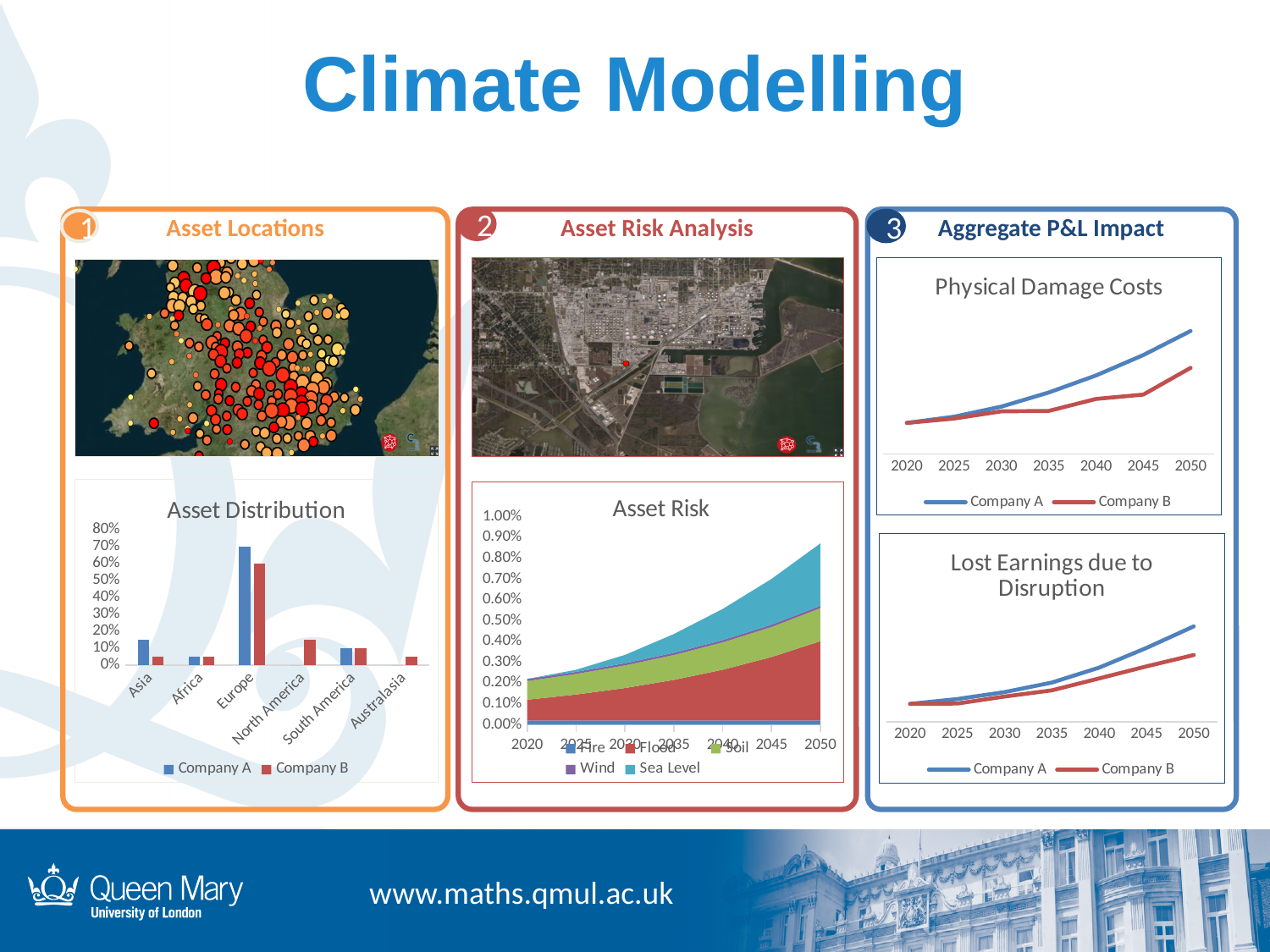
In the Asset Distribution chart, is the Company B value for Europe greater or less than 70%? less In the Asset Risk chart, is the total stacked value in 2050 greater or less than 0.80%? greater How many series does the legend of the Asset Distribution chart list? 2 In the Asset Risk chart, do the stacked values rise or fall from 2020 to 2050? rise In the Asset Distribution chart, which company has the larger value for Europe? Company A In the Asset Distribution chart, is the Company A value for Europe greater or less than 60%? greater In the Asset Distribution chart, which region has the highest value for Company A? Europe How many series does the legend of the Asset Risk chart list? 5 In the Physical Damage Costs chart, which company has the higher value in 2050? Company A In the Lost Earnings due to Disruption chart, do the values for Company A rise or fall from 2020 to 2050? rise What kind of chart is the Asset Distribution chart? bar chart How many regions are shown on the x axis of the Asset Distribution chart? 6